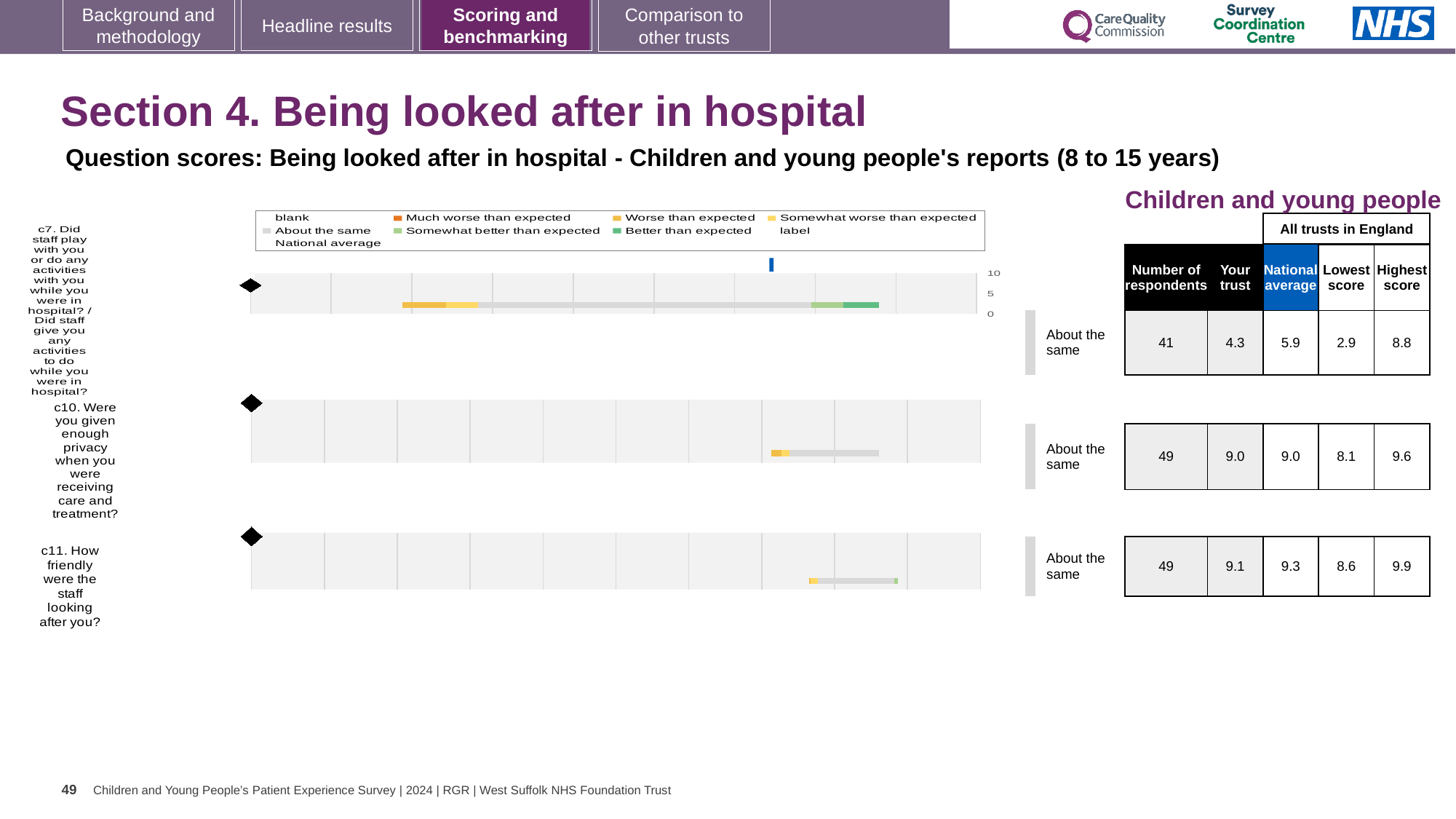
How many questions (c7, c10, c11) are plotted on the slide? 3 What is the national average score for question c10 (Were you given enough privacy when you were receiving care and treatment?)? 9.0 For question c11, which is larger: the 'Your trust' score or the national average? National average How many entries does the chart legend list? 9 What kind of chart is used to show the question scores on this slide? bar chart What is the 'Your trust' score for question c7 (Did staff play with you or do any activities with you while you were in hospital?)? 4.3 What is the highest score among all trusts in England for question c11 (How friendly were the staff looking after you?)? 9.9 How many respondents answered question c7? 41 What benchmark category is shown for all three questions on this slide? About the same Which question has the lowest 'Your trust' score? c7. Did staff play with you or do any activities with you while you were in hospital? What is the difference between the highest score and the lowest score for question c7? 5.9 Which question has the highest 'Your trust' score? c11. How friendly were the staff looking after you?